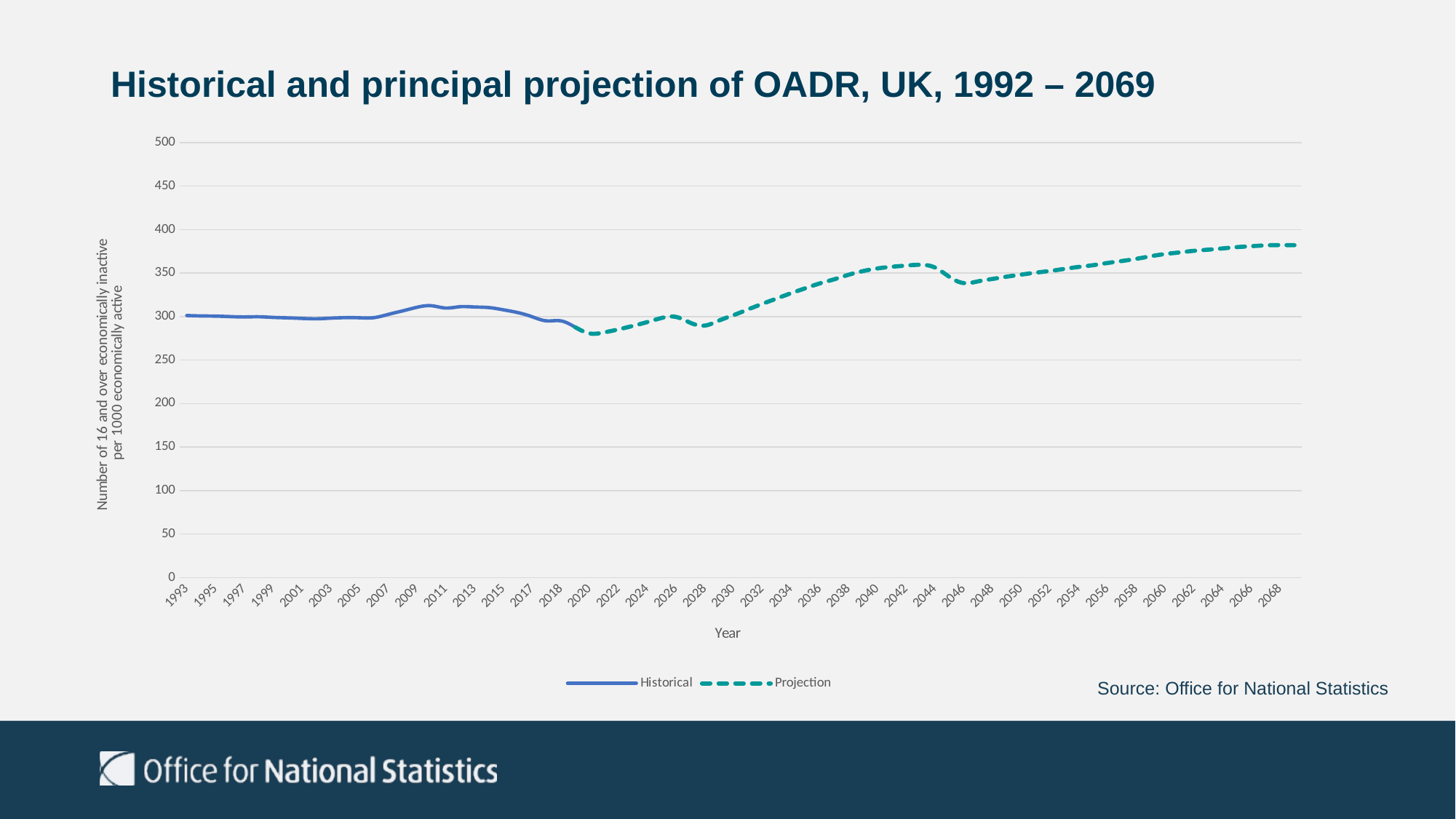
Which is larger: the Projection value for 2020 or the Projection value for 2040? 2040 What kind of chart is shown on the slide? Line chart How many series does the legend list? 2 Is the Projection value for 2026 greater or less than 350? less What are the two series named in the legend? Historical and Projection Is the Historical value for 2009 greater or less than 350? less Is the Historical value for 1993 greater or less than 250? greater What is the title of the chart? Historical and principal projection of OADR, UK, 1992 – 2069 Which is larger: the Historical value for 1993 or the Projection value for 2068? Projection value for 2068 Does the Projection series rise or fall between 2046 and 2068? rise